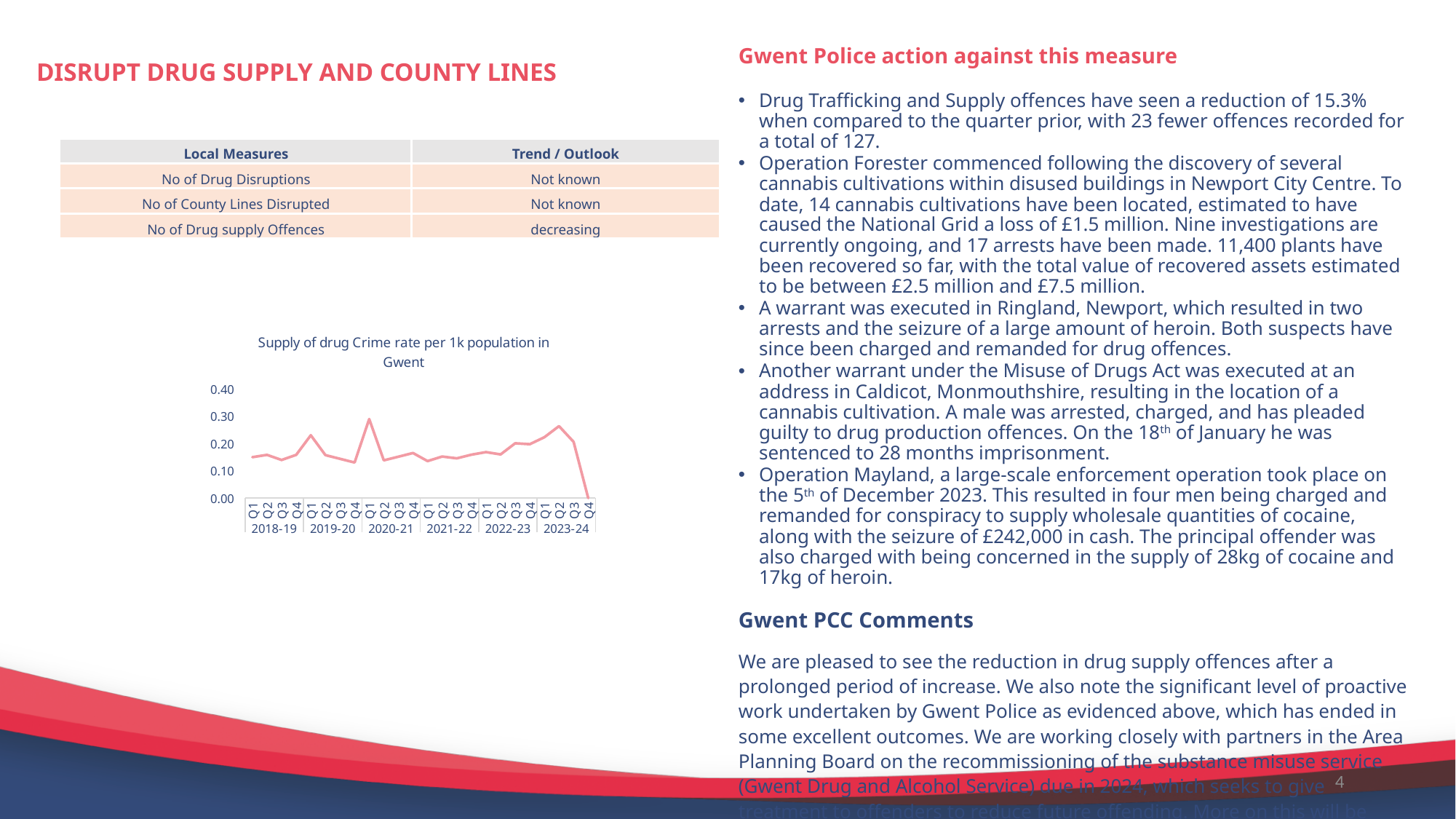
How many quarterly data points are plotted on the chart? 24 What is the highest value shown on the y axis of the chart? 0.40 How many financial years are shown on the x axis of the chart? 6 What is the title of the chart? Supply of drug Crime rate per 1k population in Gwent Is the value for 2018-19 Q1 greater or less than 0.20? less Which is larger, the value for 2019-20 Q1 or the value for 2019-20 Q3? 2019-20 Q1 Is the value for 2023-24 Q2 greater or less than 0.20? greater Which quarter has the lowest value on the chart? 2023-24 Q4 Is the value for 2020-21 Q1 greater or less than 0.20? greater What kind of chart is shown on the slide? line chart Do the values rise or fall from 2023-24 Q2 to 2023-24 Q4? fall